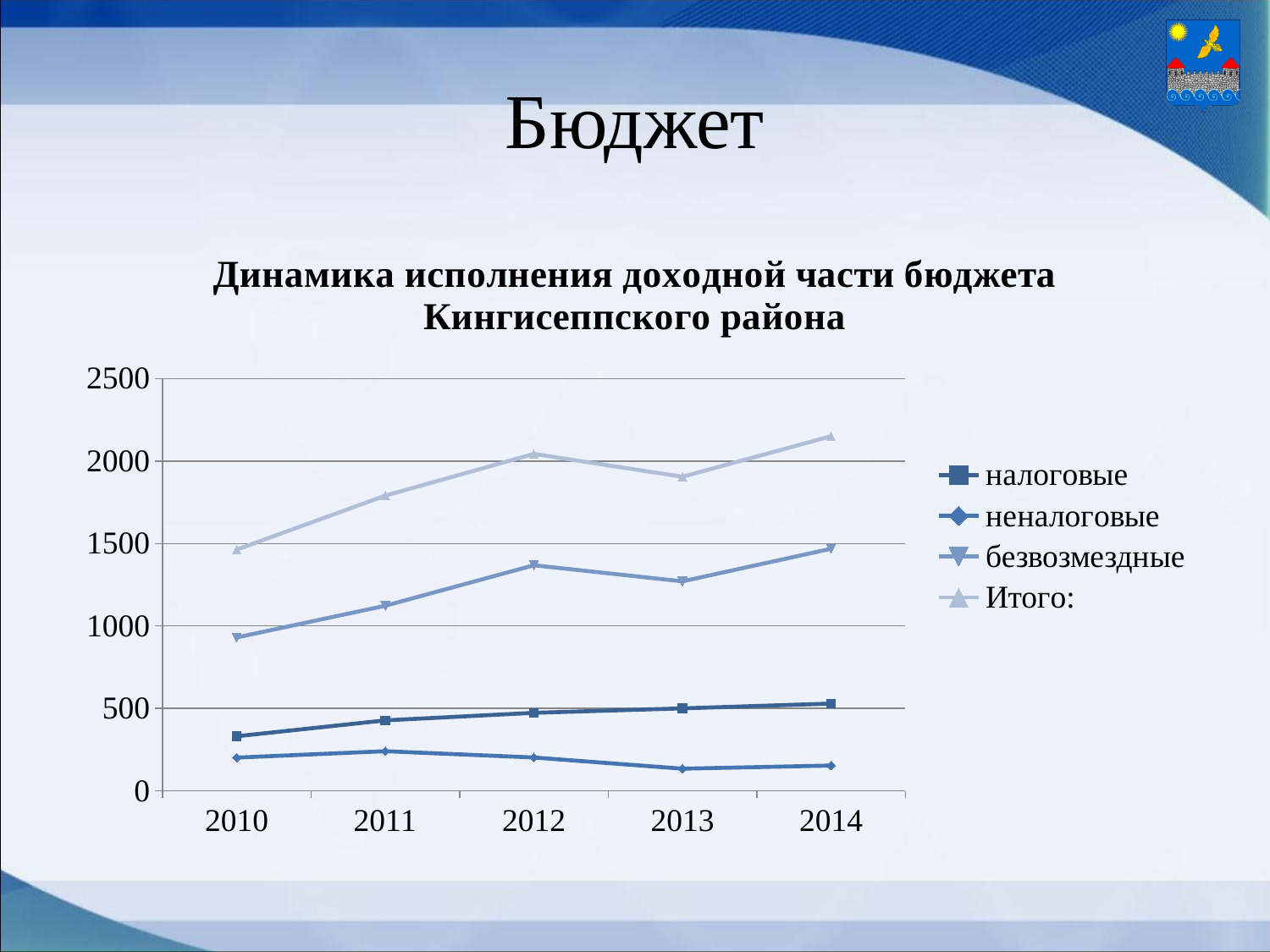
Which is larger for безвозмездные: the value in 2012 or the value in 2013? 2012 Which series has the lowest values across all years? неналоговые How many years are plotted along the x axis? 5 Which series has the highest values across all years? Итого: Do the values for налоговые rise or fall from 2010 to 2014? rise Is the value for безвозмездные in 2010 greater or less than 1000? less In which year is the value for Итого: the highest? 2014 Is the value for налоговые in 2010 greater or less than 500? less In which year is the value for Итого: the lowest? 2010 Is the value for Итого: in 2014 greater or less than 2000? greater What kind of chart is shown on the slide? line chart How many series does the legend list? 4